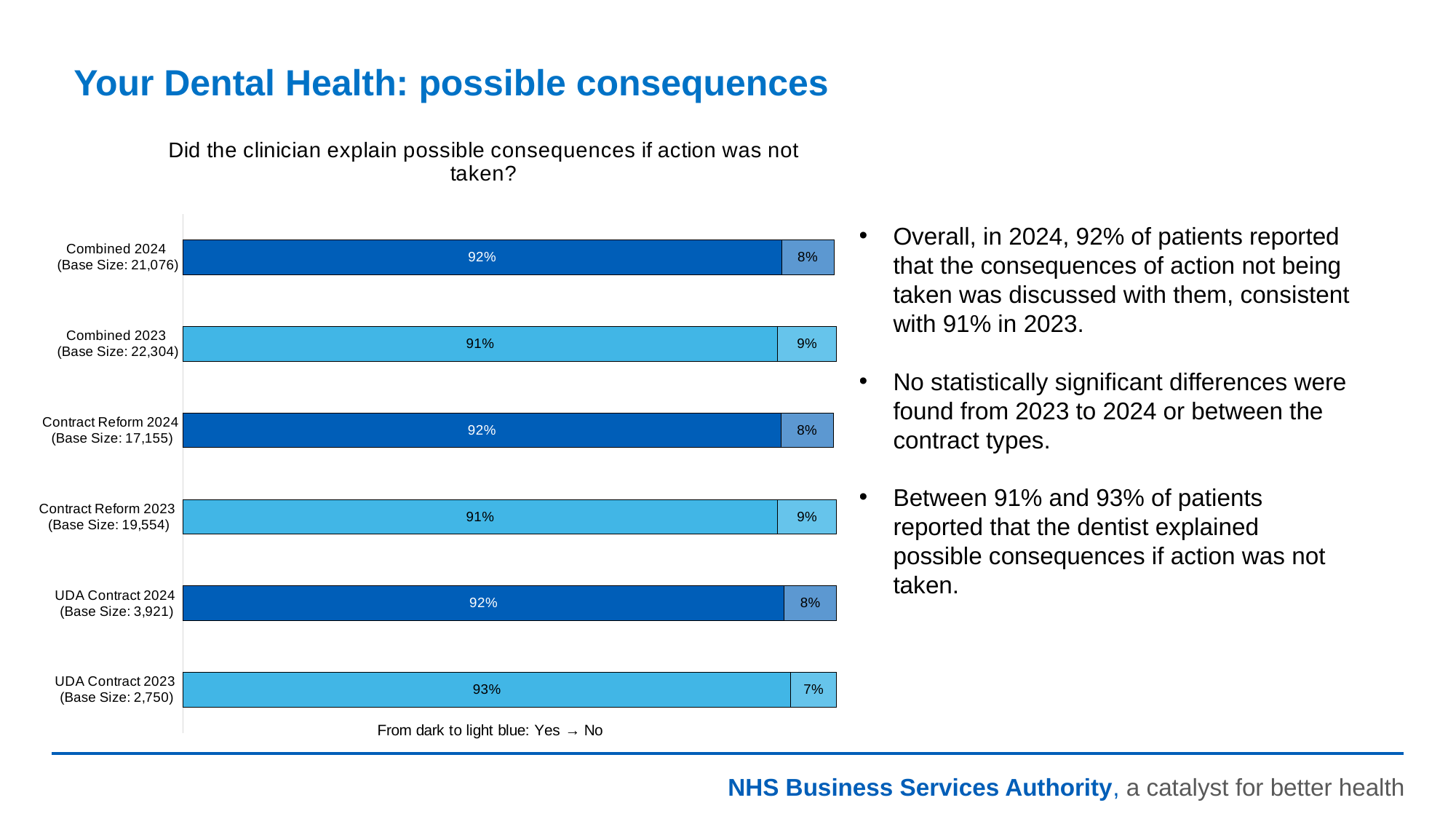
Which category has the lowest No percentage? UDA Contract 2023 What kind of chart is shown on the slide? Stacked bar chart What is the total of the Yes and No segments for Combined 2024? 100% What is the Yes value for Contract Reform 2023? 91% What is the No value for Combined 2023? 9% What percentage of Combined 2024 respondents answered Yes? 92% What is the difference between the Yes percentage for UDA Contract 2023 and UDA Contract 2024? 1% What is the base size shown for Contract Reform 2024? 17,155 Which is larger, the Yes percentage for Contract Reform 2024 or Contract Reform 2023? Contract Reform 2024 Which category has the highest Yes percentage? UDA Contract 2023 What percentage of UDA Contract 2023 respondents answered No? 7% How many categories are shown on the chart? 6